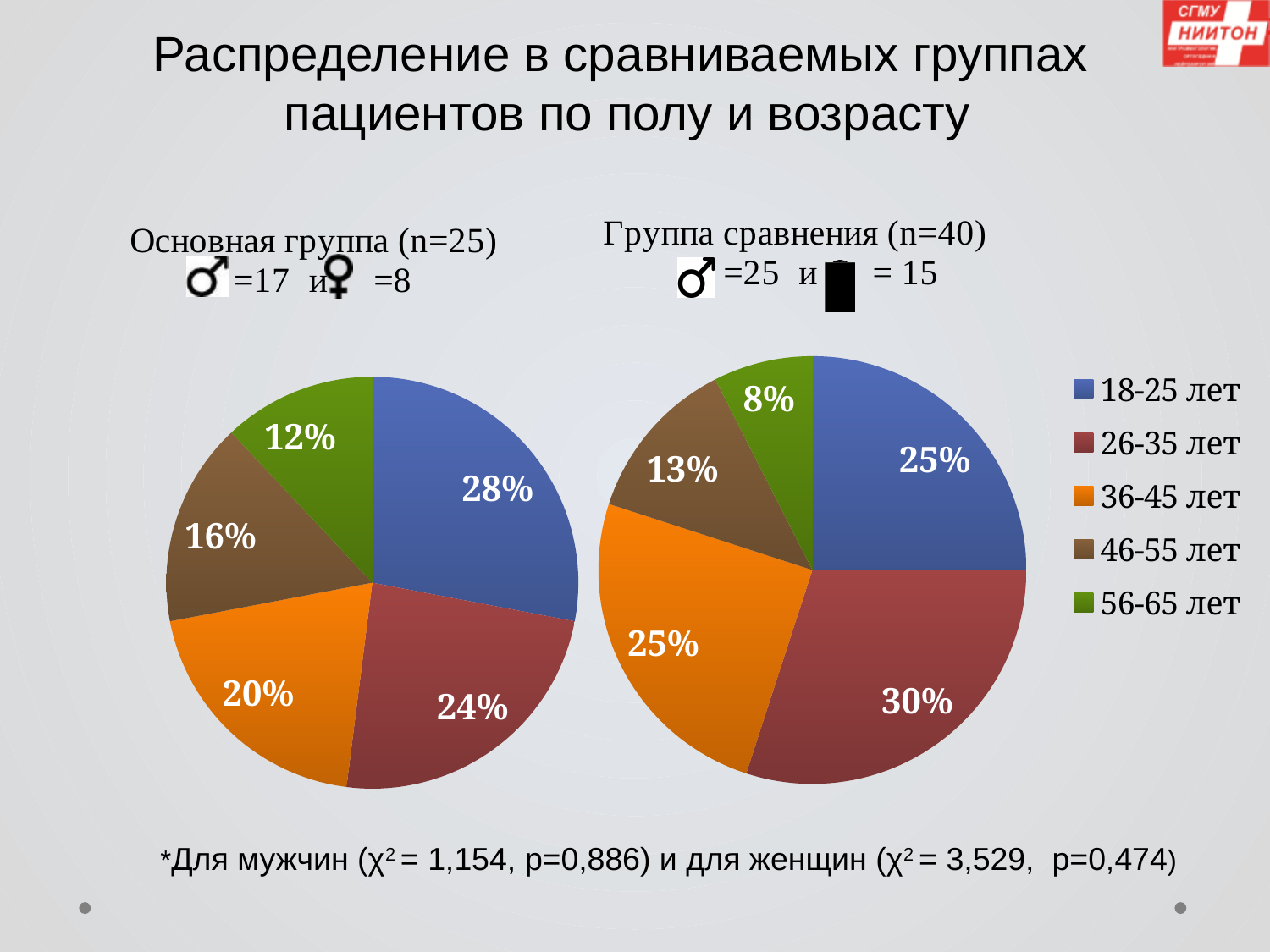
What type of chart is used on this slide? Pie chart How many age groups does the legend list? 5 In the left pie chart (Основная группа), what share is the 46-55 лет slice? 16% Which colour represents the 36-45 лет age group in the legend? Orange In the right pie chart (Группа сравнения), what is the difference between the 46-55 лет share and the 56-65 лет share? 5% In the left pie chart (Основная группа, n=25), what share is the 18-25 лет slice? 28% In the right pie chart (Группа сравнения), which age group has the largest share? 26-35 лет In the left pie chart (Основная группа), what is the difference between the 18-25 лет share and the 56-65 лет share? 16% In the right pie chart (Группа сравнения, n=40), what share is the 26-35 лет slice? 30% Which is larger: the 36-45 лет share in the left pie chart (Основная группа) or the 36-45 лет share in the right pie chart (Группа сравнения)? Группа сравнения In the right pie chart (Группа сравнения), what share is the 56-65 лет slice? 8% In the left pie chart (Основная группа), which age group has the smallest share? 56-65 лет